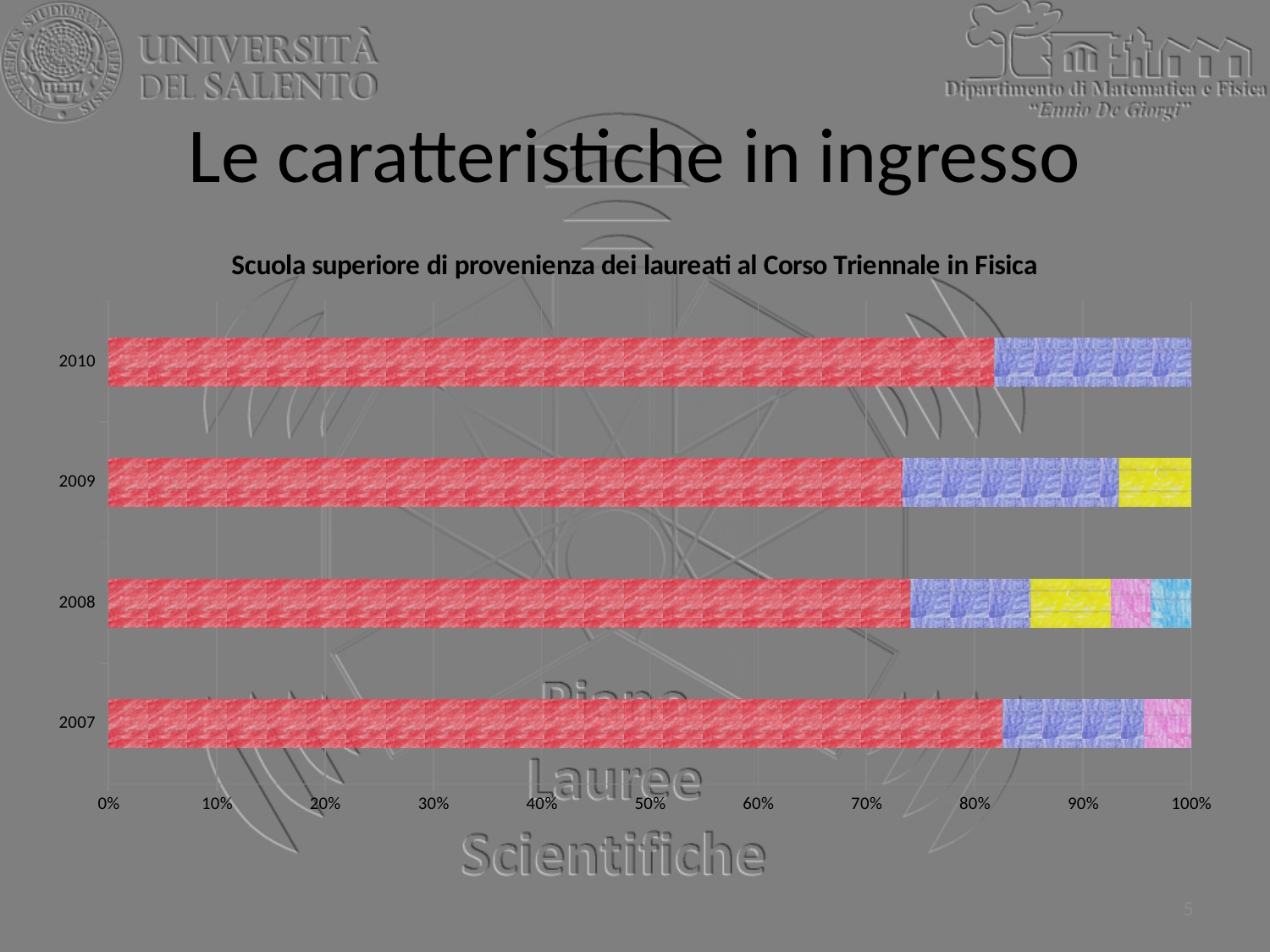
Which year's bar is made up of the most segments? 2008 What kind of chart is shown on the slide? bar chart Which is larger, the red segment for 2010 or the red segment for 2009? 2010 What colour is the largest segment in every bar? red What is the title of the chart? Scuola superiore di provenienza dei laureati al Corso Triennale in Fisica How many coloured segments make up the bar for 2010? 2 Is the red segment for 2009 greater or less than 80%? less Is the red segment for 2008 greater or less than 80%? less Is the red segment for 2007 greater or less than 70%? greater How many years (categories) are shown on the chart? 4 How many coloured segments make up the bar for 2008? 5